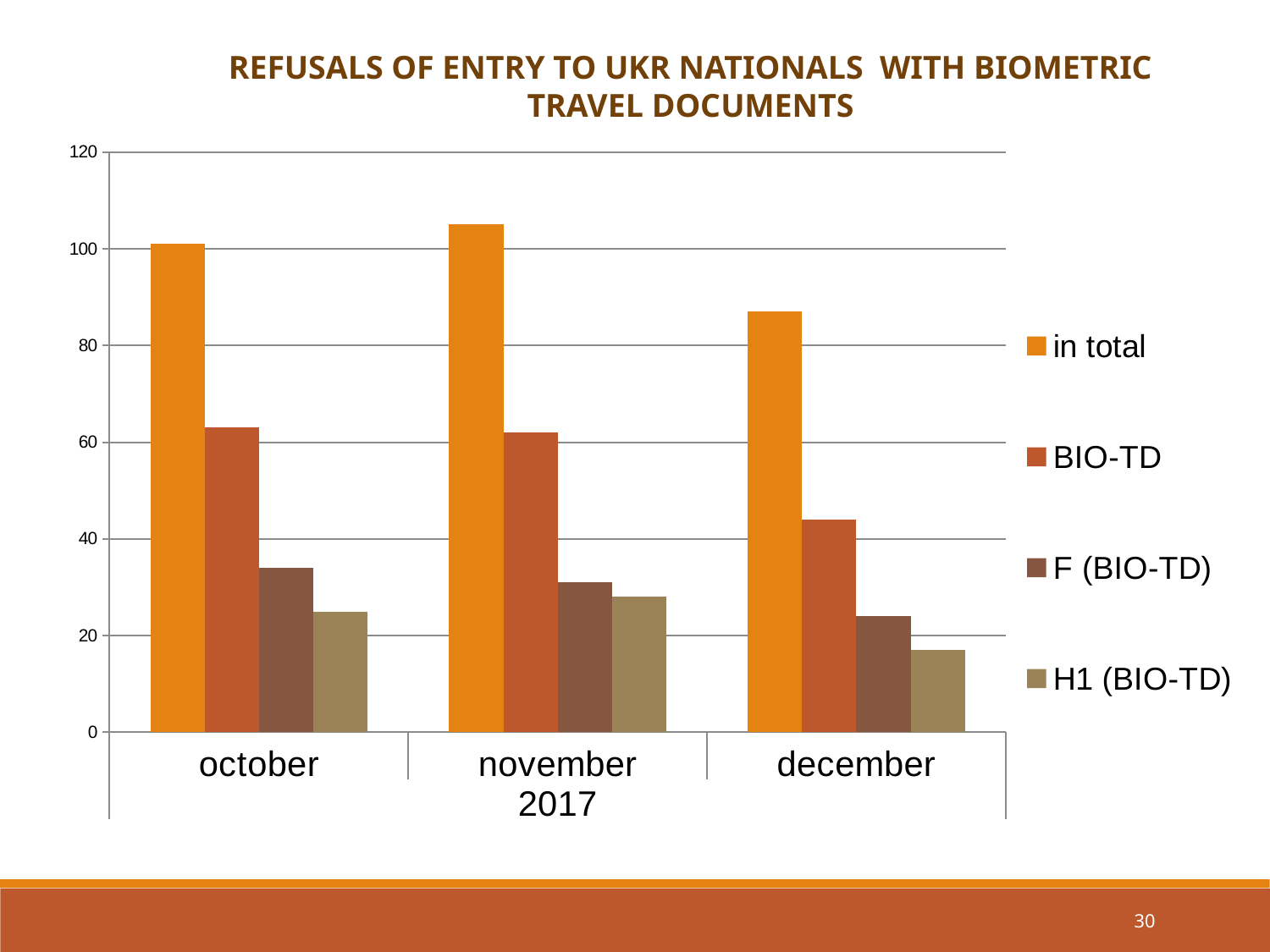
Do the 'F (BIO-TD)' values rise or fall from october to december? fall Is the 'F (BIO-TD)' value for october greater or less than 40? less Is the 'in total' value for december greater or less than 100? less In october, which is larger: 'F (BIO-TD)' or 'H1 (BIO-TD)'? F (BIO-TD) What kind of chart is shown on the slide? bar chart How many months are shown on the x axis? 3 Is the 'H1 (BIO-TD)' value for december greater or less than 20? less How many series does the legend list? 4 In which month is the 'BIO-TD' value lowest? december In which month is the 'in total' value lowest? december In which month is the 'H1 (BIO-TD)' value lowest? december